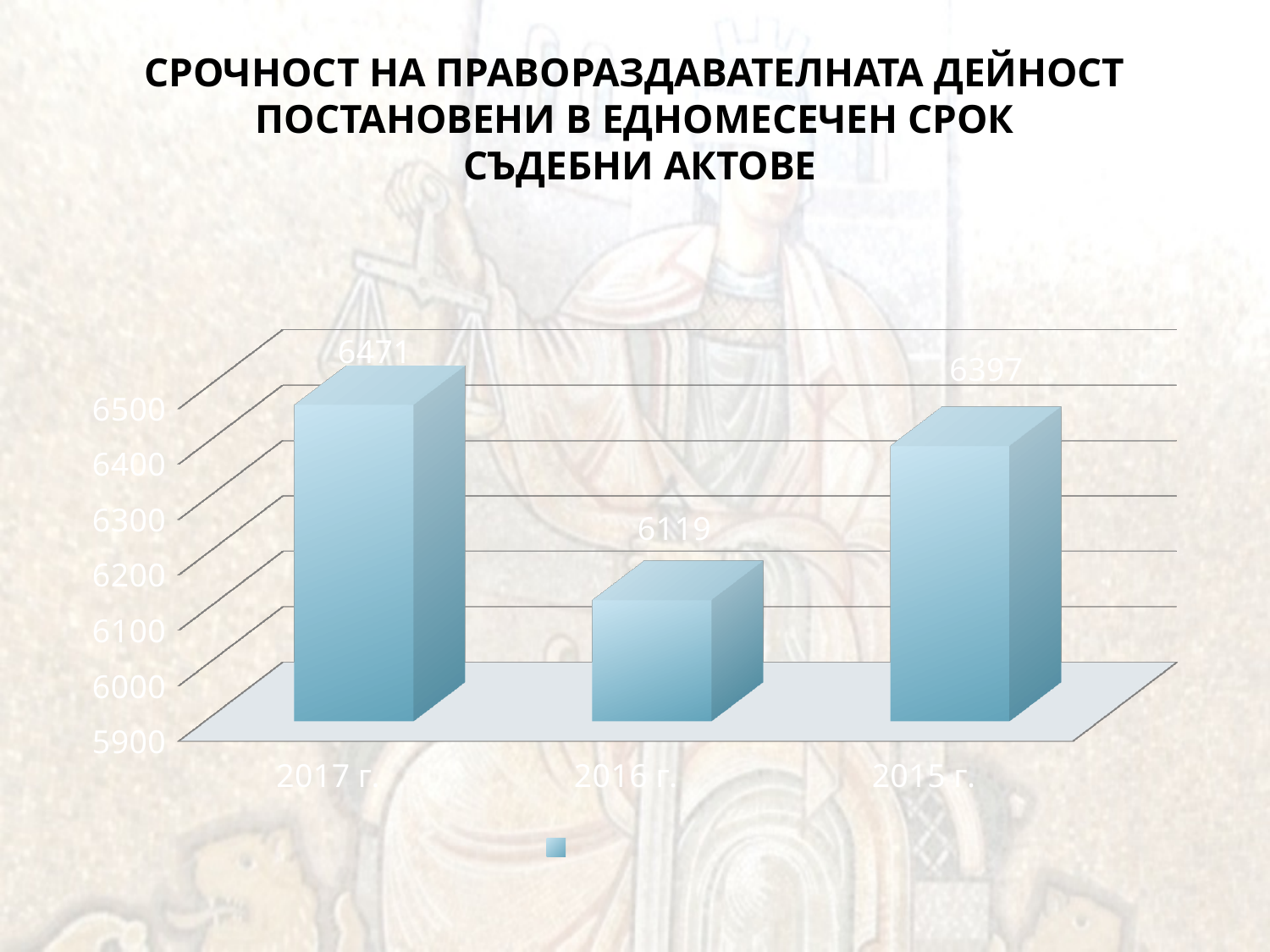
What is the first line of the chart's title? СРОЧНОСТ НА ПРАВОРАЗДАВАТЕЛНАТА ДЕЙНОСТ How many categories are shown on the x axis? 3 Which year has the highest value? 2017 г. Which year has the lowest value? 2016 г. What is the difference between the values for 2017 г. and 2016 г.? 352 Which is larger, the value for 2015 г. or the value for 2016 г.? 2015 г. What kind of chart is shown on the slide? bar chart What is the value for 2016 г.? 6119 What is the value for 2015 г.? 6397 What is the difference between the values for 2017 г. and 2015 г.? 74 Is the value for 2016 г. greater or less than 6200? less What is the value for 2017 г.? 6471